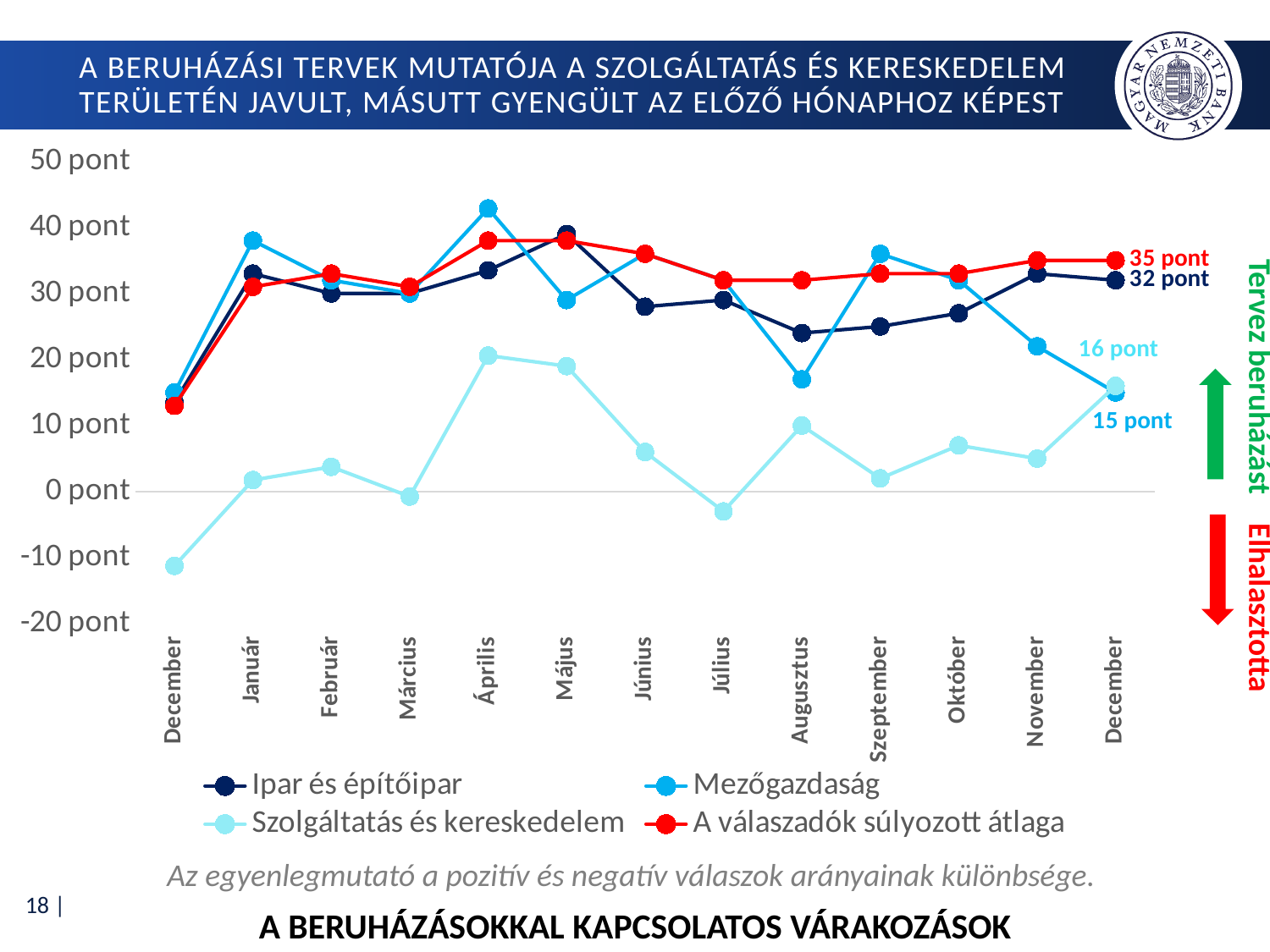
In the final December, which is larger: 'Ipar és építőipar' or 'Mezőgazdaság'? Ipar és építőipar What is the value of 'A válaszadók súlyozott átlaga' in the final December? 35 pont What is the value of 'Szolgáltatás és kereskedelem' in the final December? 16 pont Is the value for 'Szolgáltatás és kereskedelem' in the first December greater or less than 0 pont? less What is the value of 'Mezőgazdaság' in the final December? 15 pont What kind of chart is shown on the slide? line chart How many series does the legend list? 4 What is the value of 'Ipar és építőipar' in the final December? 32 pont How many months are plotted along the x axis? 13 In the final December, how much higher is 'A válaszadók súlyozott átlaga' than 'Ipar és építőipar'? 3 pont Is the value for 'Mezőgazdaság' in Április greater or less than 40 pont? greater Which series has the lowest value in the first December? Szolgáltatás és kereskedelem